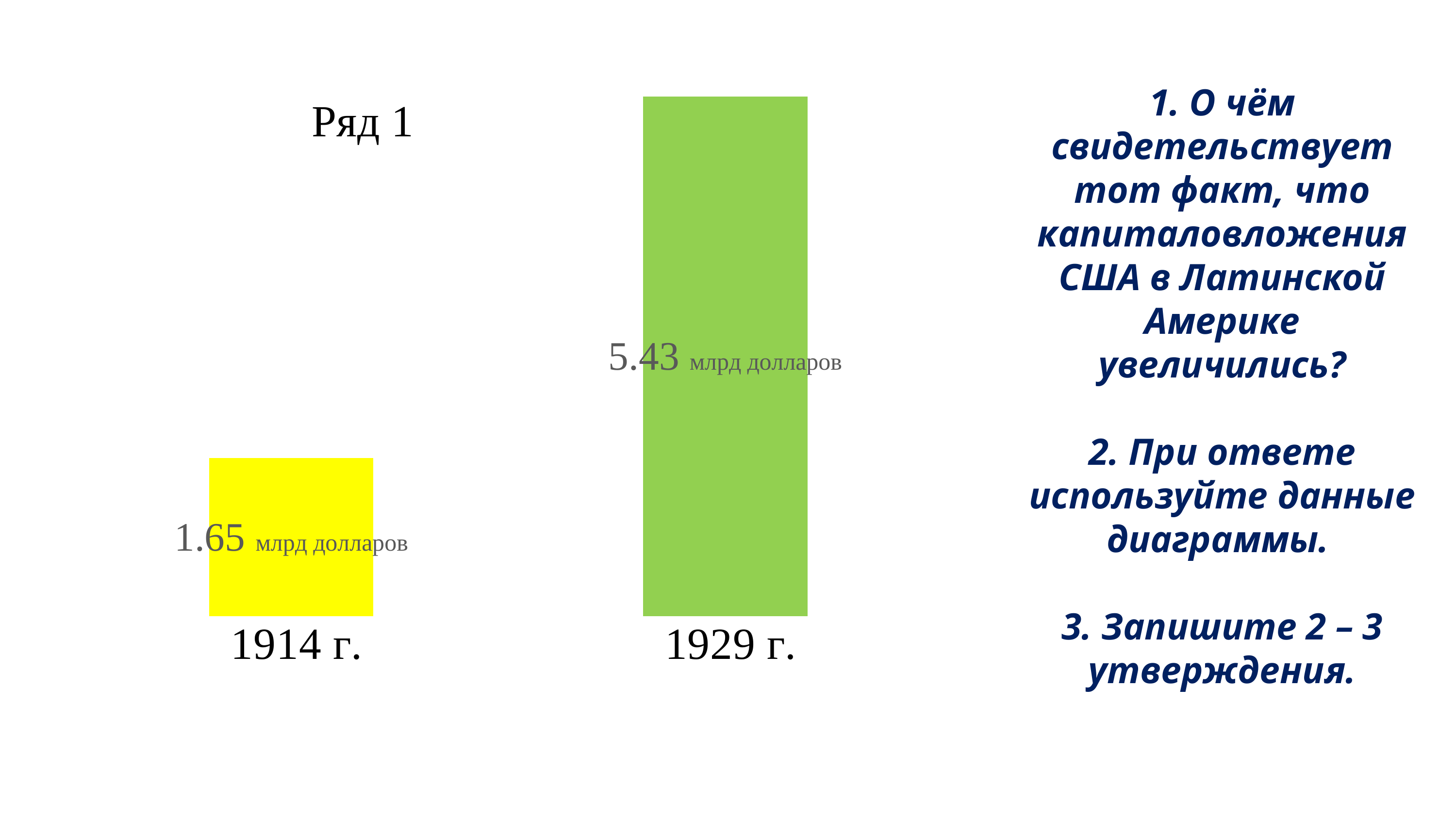
What is the difference between the values for 1929 г. and 1914 г.? 3.78 млрд долларов What colour is the bar for 1929 г.? green Do the values rise or fall from 1914 г. to 1929 г.? rise What kind of chart is shown on the slide? bar chart Which is larger, the value for 1914 г. or the value for 1929 г.? 1929 г. Which year has the highest value? 1929 г. What is the value for 1929 г.? 5.43 млрд долларов What is the value for 1914 г.? 1.65 млрд долларов How many bars are shown in the chart? 2 Which year has the lowest value? 1914 г.